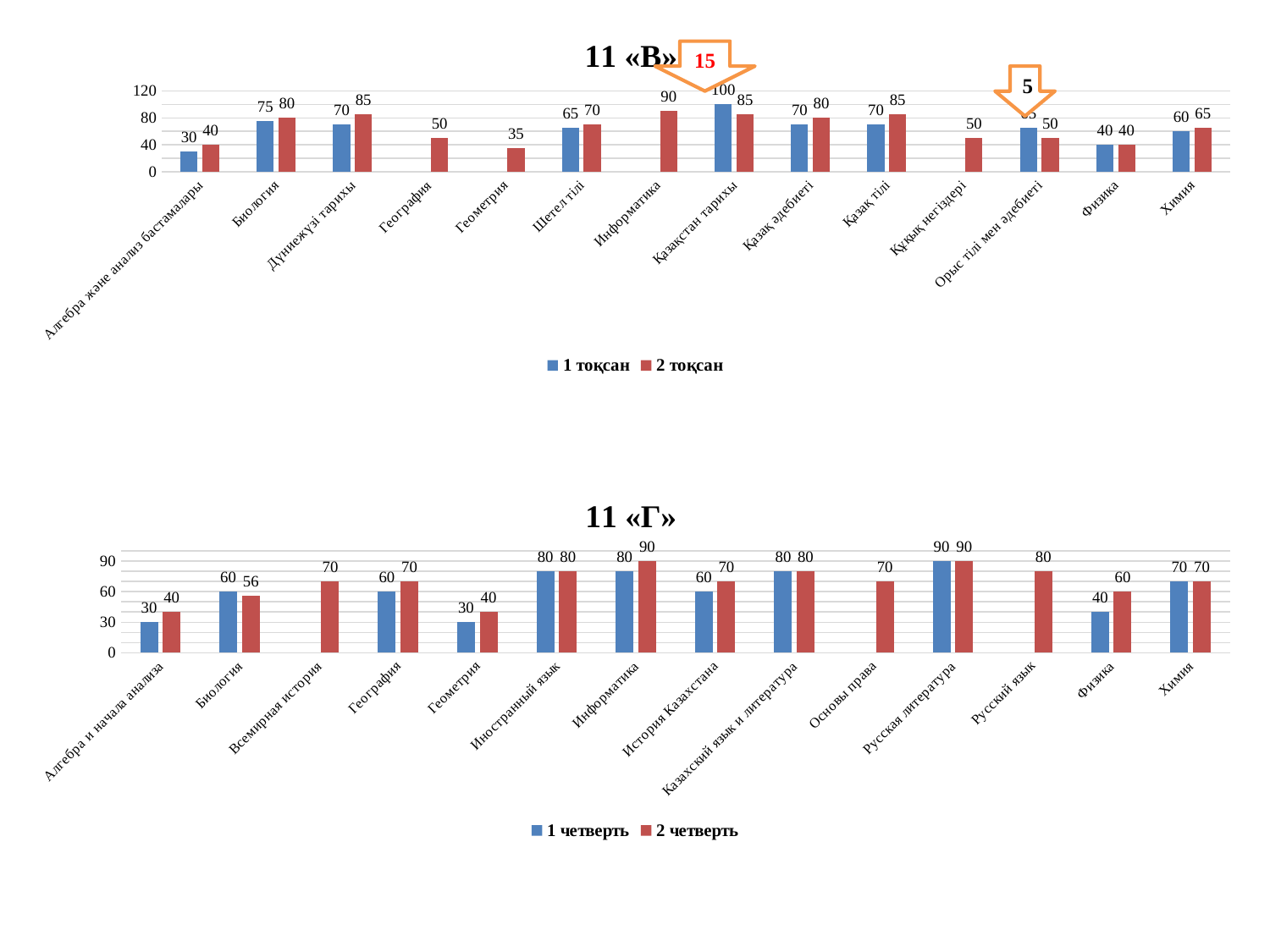
In the chart titled 11 «В», which category has the highest 1 тоқсан value? Қазақстан тарихы In the chart titled 11 «Г», how many categories are shown on the x axis? 14 In the chart titled 11 «Г», what is the difference between the 2 четверть and 1 четверть values for Физика? 20 What type of chart is the chart titled 11 «Г»? Bar chart In the chart titled 11 «Г», what are the two legend entries? 1 четверть and 2 четверть In the chart titled 11 «Г», what is the value of 2 четверть for Биология? 56 In the chart titled 11 «Г», which is larger for Физика: 1 четверть or 2 четверть? 2 четверть In the chart titled 11 «В», what is the difference between the 2 тоқсан and 1 тоқсан values for Дүниежүзі тарихы? 15 In the chart titled 11 «В», what is the value of 2 тоқсан for Информатика? 90 In the chart titled 11 «В», what is the value of 1 тоқсан for Қазақстан тарихы? 100 In the chart titled 11 «В», how many series does the legend list? 2 In the chart titled 11 «В», which category has the lowest 2 тоқсан value? Геометрия